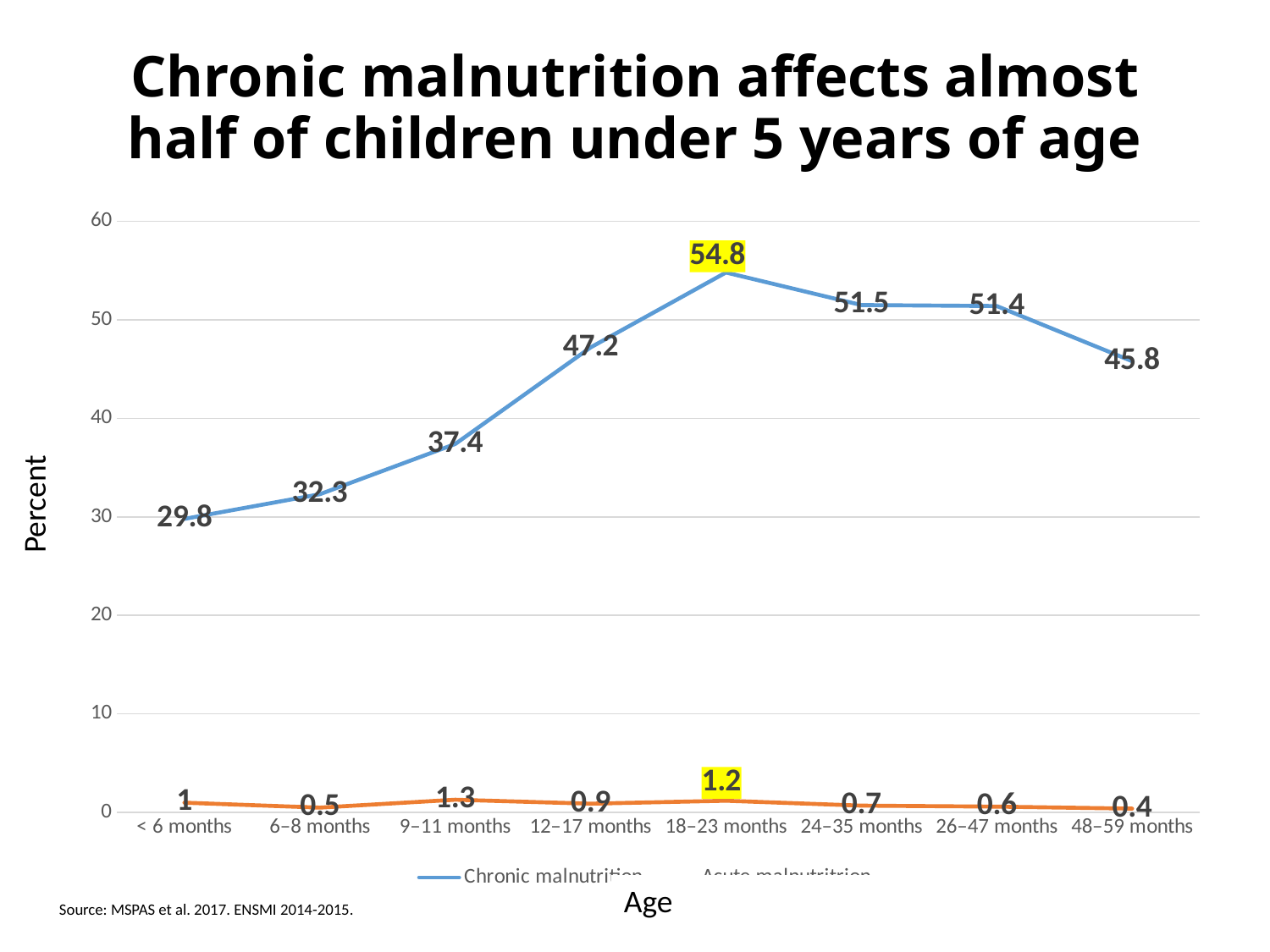
Which age group has the lowest acute malnutrition value? 48–59 months Does the chronic malnutrition line rise or fall from < 6 months to 18–23 months? Rises What is the acute malnutrition value for the 9–11 months age group? 1.3 What kind of chart is shown on the slide? Line chart What is the chronic malnutrition value for the 18–23 months age group? 54.8 Which has a higher chronic malnutrition value: 9–11 months or 12–17 months? 12–17 months How many series does the legend list? 2 What is the difference between the chronic malnutrition values for 18–23 months and 48–59 months? 9 What is the chronic malnutrition value for children under 6 months? 29.8 How many age groups are shown on the x axis? 8 Which age group has the highest chronic malnutrition value? 18–23 months Which age group has the lowest chronic malnutrition value? < 6 months